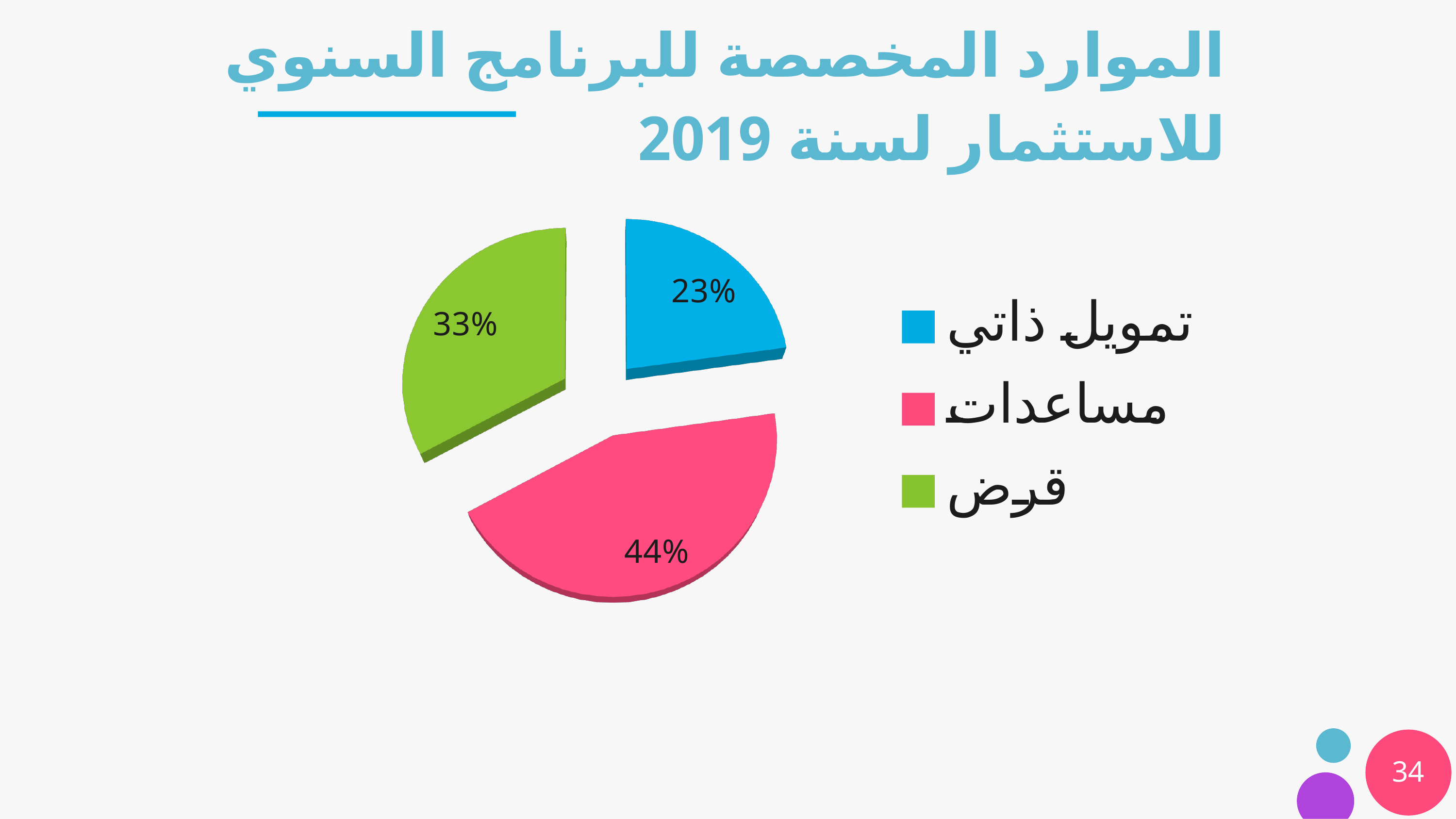
Which category has the smallest slice of the pie? تمويل ذاتي What share of the pie does قرض represent? 33% How many slices does the pie chart have? 3 What kind of chart is shown on the slide? Pie chart What is the difference in percentage points between مساعدات and تمويل ذاتي? 21 What colour is the slice for قرض? Green What is the difference in percentage points between قرض and تمويل ذاتي? 10 What share of the pie does تمويل ذاتي represent? 23% Which category has the largest slice of the pie? مساعدات What is the title of the chart on the slide? الموارد المخصصة للبرنامج السنوي للاستثمار لسنة 2019 Which is larger, the share for قرض or the share for مساعدات? مساعدات What share of the pie does مساعدات represent? 44%